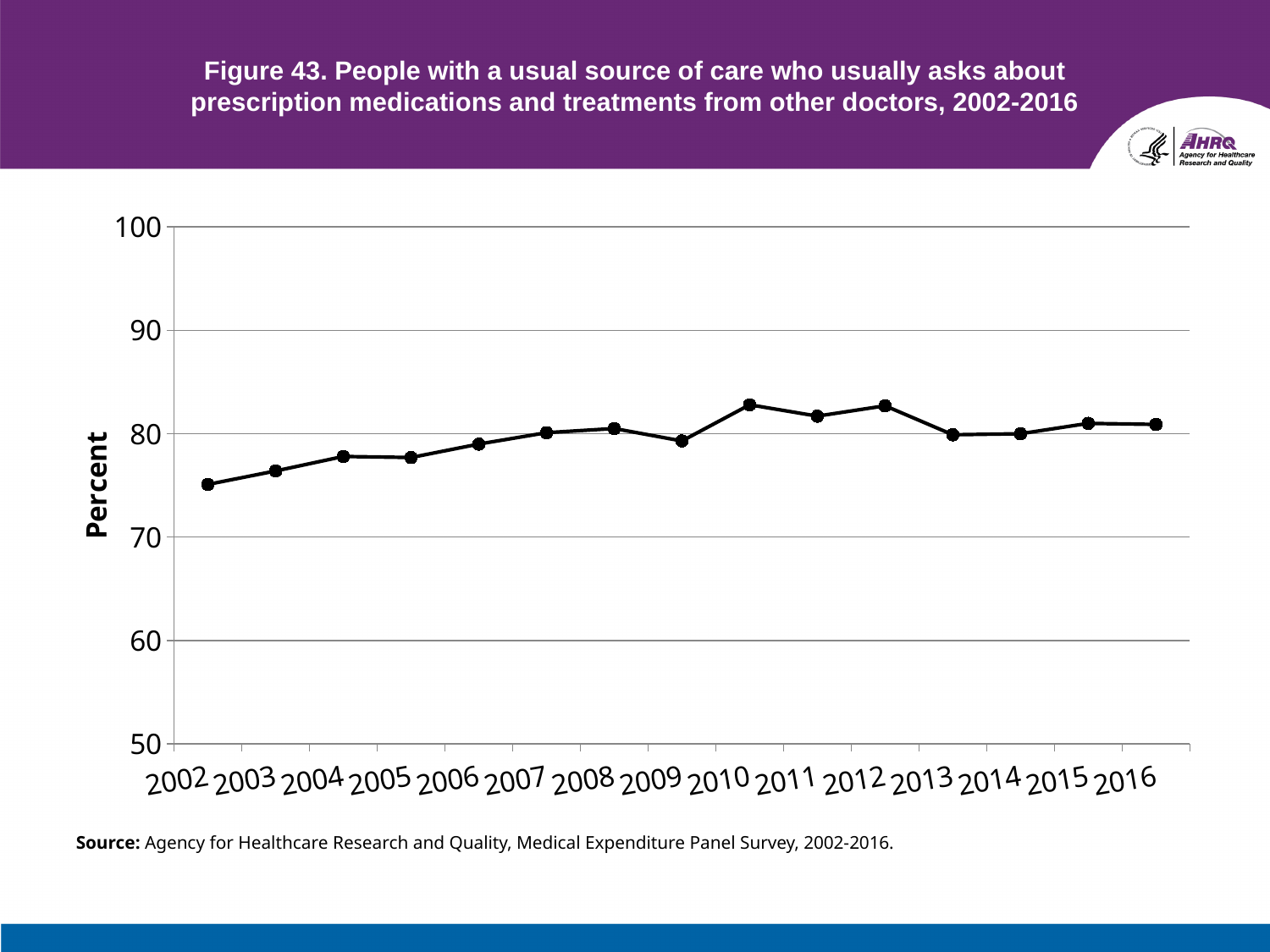
Is the value for 2003 greater or less than 80? less What kind of chart is shown on the slide? line chart Is the value for 2012 greater or less than 80? greater Is the value for 2002 greater or less than 80? less Overall, do the values rise or fall from 2002 to 2016? rise Which is larger, the value for 2004 or the value for 2011? 2011 Which is larger, the value for 2002 or the value for 2010? 2010 Which year has the lowest value on the chart? 2002 What is the label on the vertical axis of the chart? Percent How many years (data points) are plotted on the chart? 15